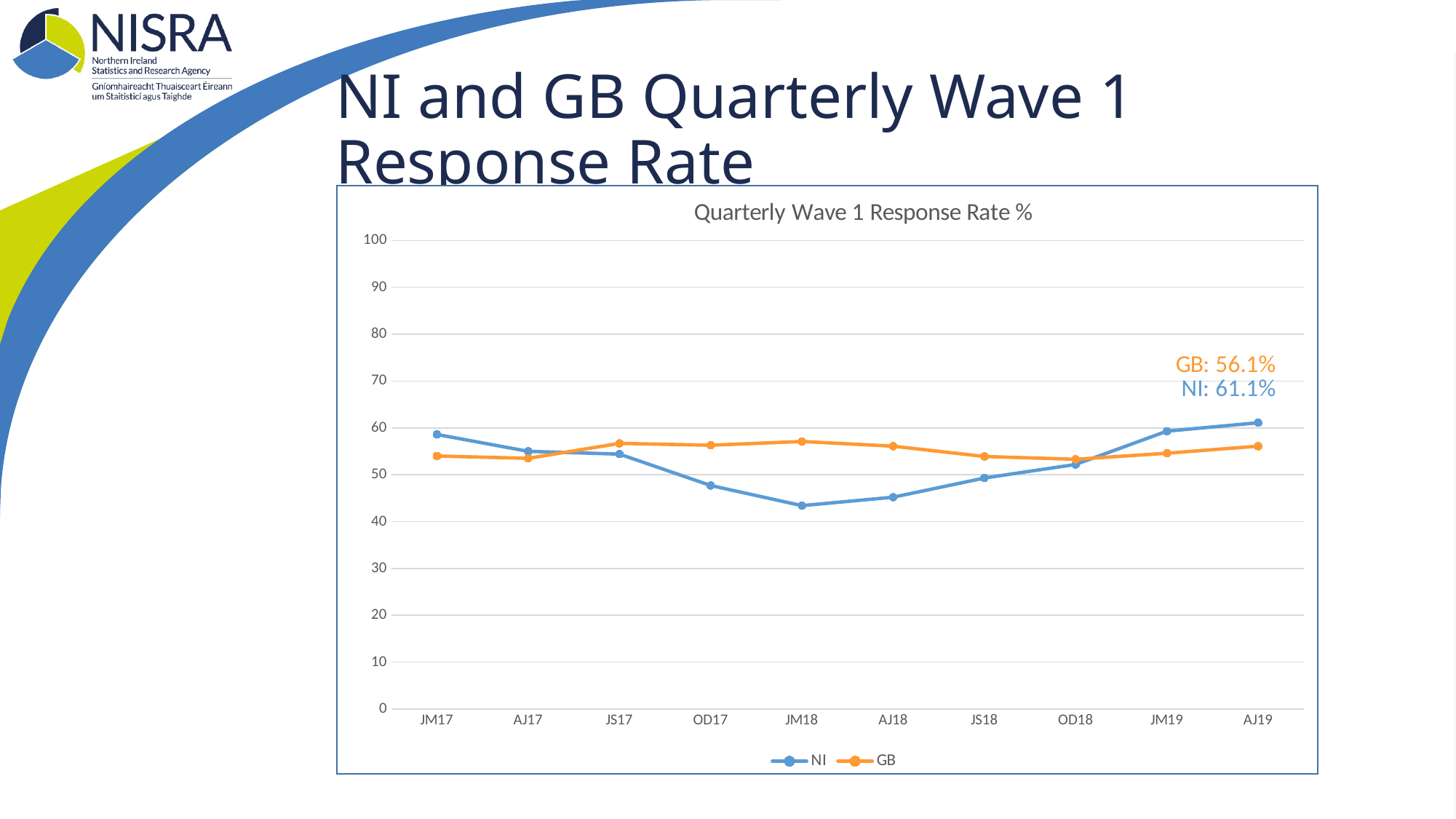
What is the difference between the NI and GB response rates at AJ19? 5.0% Is the GB value for JM18 greater or less than 50? greater What is the NI response rate for AJ19? 61.1% In which quarter is the NI response rate lowest? JM18 How many quarters are shown on the x axis? 10 What is the GB response rate for AJ19? 56.1% What kind of chart is shown on the slide? Line chart In which quarter is the NI response rate highest? AJ19 At AJ19, which series has the higher response rate, NI or GB? NI How many series does the legend list? 2 At JM18, which series has the higher response rate, NI or GB? GB Is the NI value for JM18 greater or less than 50? less